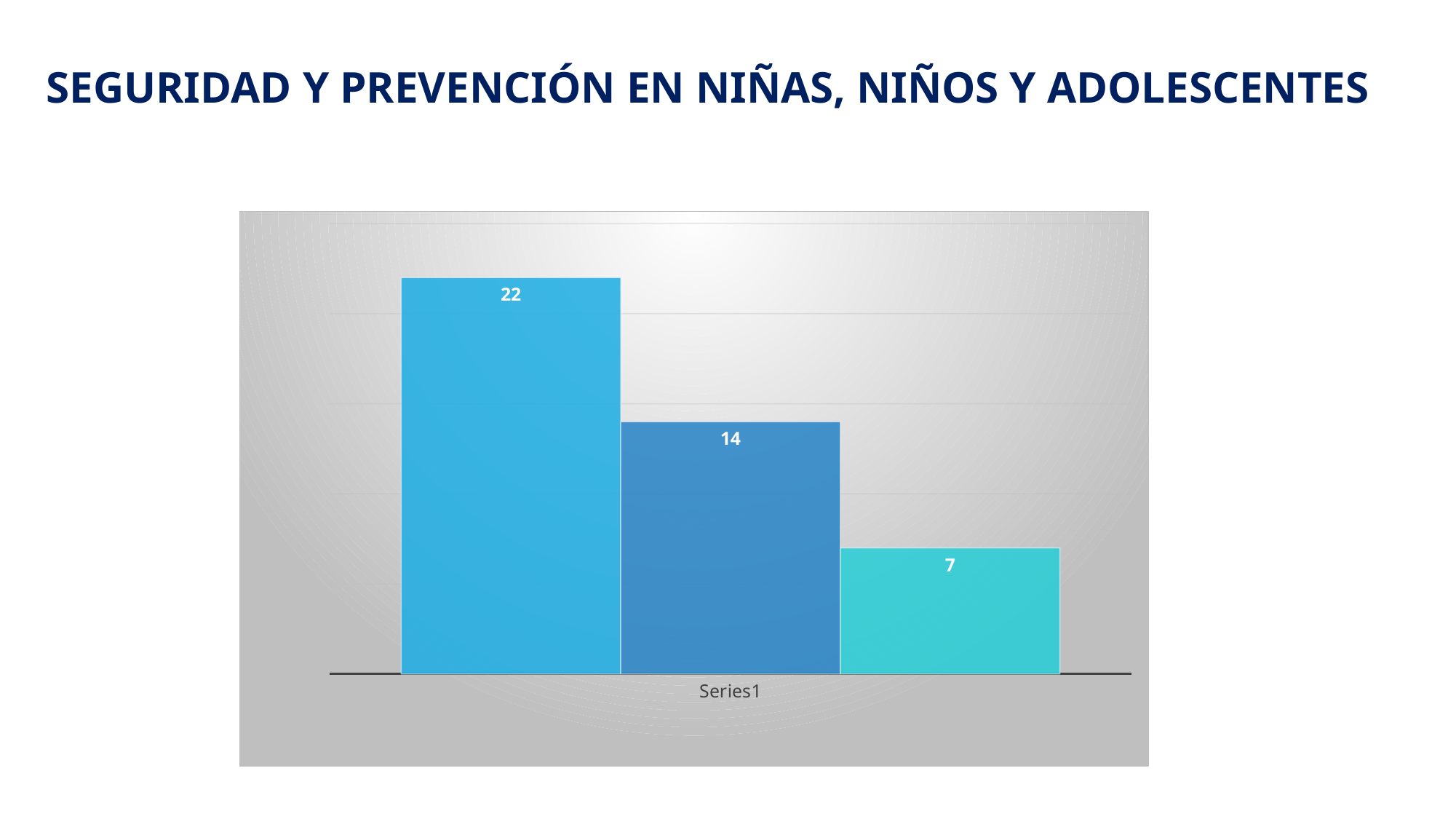
What is the difference between the leftmost bar and the middle bar? 8 Do the bar values rise or fall from left to right? fall What is the value shown on the leftmost bar? 22 What is the lowest value shown in the chart? 7 What label is shown on the horizontal axis of the chart? Series1 What is the difference between the middle bar and the rightmost bar? 7 What is the highest value shown in the chart? 22 How many bars are plotted in the chart? 3 Which is larger, the leftmost bar or the rightmost bar? the leftmost bar What is the value shown on the rightmost bar? 7 What is the value shown on the middle bar? 14 What kind of chart is shown on the slide? bar chart